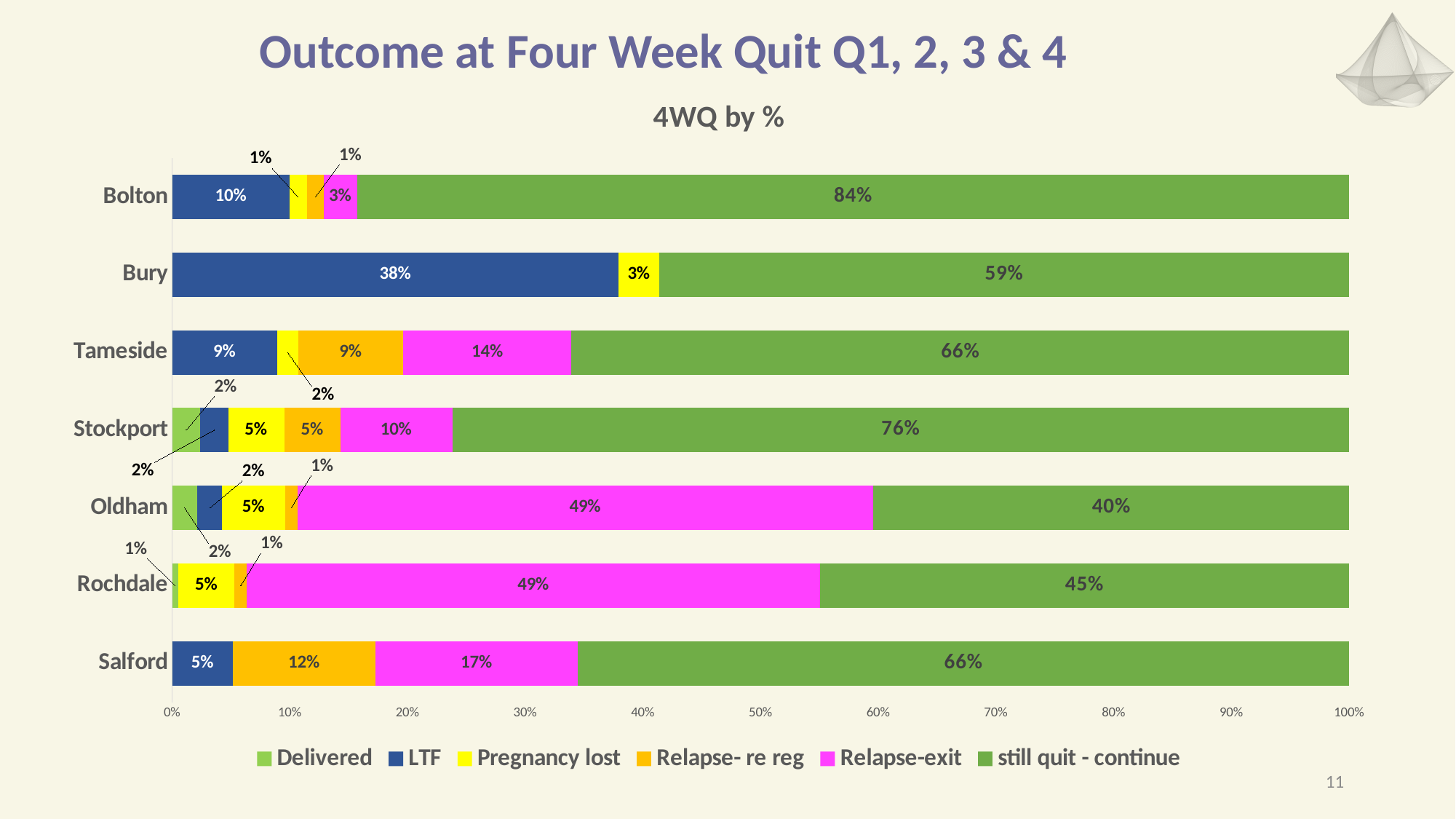
How many series does the legend list? 6 Which is larger, the Relapse-exit value for Oldham or for Salford? Oldham What is the difference between the LTF values for Bury and Bolton? 28 percentage points What is the 'still quit - continue' value for Bolton? 84% How many areas are shown on the chart? 7 What kind of chart is shown on the slide? Stacked bar chart What is the Relapse-exit value for Tameside? 14% What is the 'Relapse- re reg' value for Salford? 12% Which area has the lowest 'still quit - continue' percentage? Oldham What is the title of the chart? 4WQ by % What is the LTF value for Bury? 38% Which area has the highest 'still quit - continue' percentage? Bolton